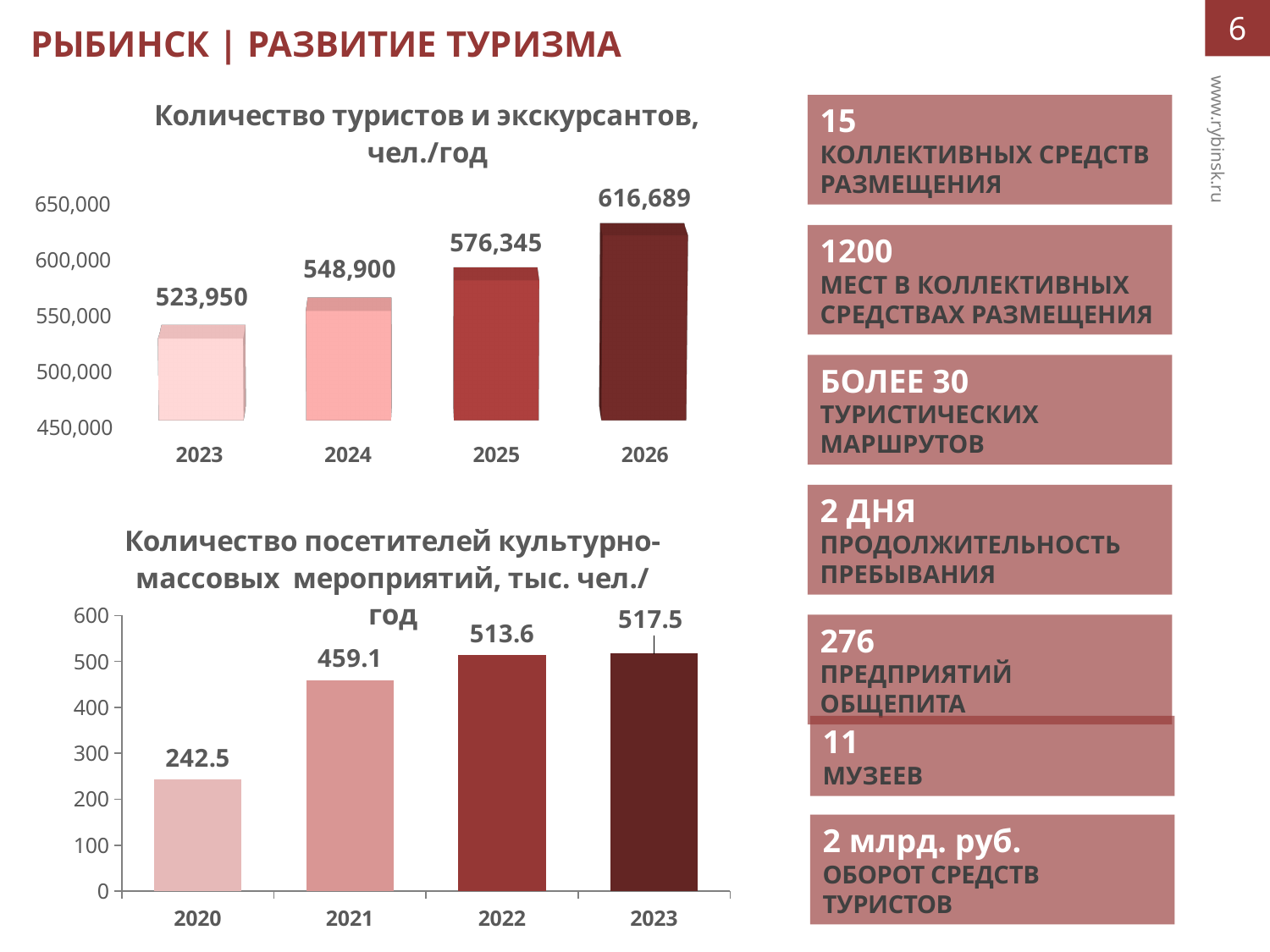
In the top chart (Количество туристов и экскурсантов), how many years are shown? 4 In the top chart (Количество туристов и экскурсантов), what is the difference between the 2026 and 2023 values? 92,739 In the bottom chart (Количество посетителей культурно-массовых мероприятий), what is the difference between the 2022 and 2021 values? 54.5 In the top chart (Количество туристов и экскурсантов), which year has the highest value? 2026 In the top chart (Количество туристов и экскурсантов), what is the value for 2025? 576,345 In the top chart (Количество туристов и экскурсантов), do the values rise or fall from 2023 to 2026? rise In the bottom chart (Количество посетителей культурно-массовых мероприятий), what is the value for 2021? 459.1 In the bottom chart (Количество посетителей культурно-массовых мероприятий), which year has the lowest value? 2020 What kind of chart is the bottom chart (Количество посетителей культурно-массовых мероприятий)? bar chart In the bottom chart (Количество посетителей культурно-массовых мероприятий), which is larger, the value for 2021 or 2022? 2022 In the bottom chart (Количество посетителей культурно-массовых мероприятий), is the value for 2020 greater or less than 300? less In the top chart (Количество туристов и экскурсантов), what is the value for 2023? 523,950